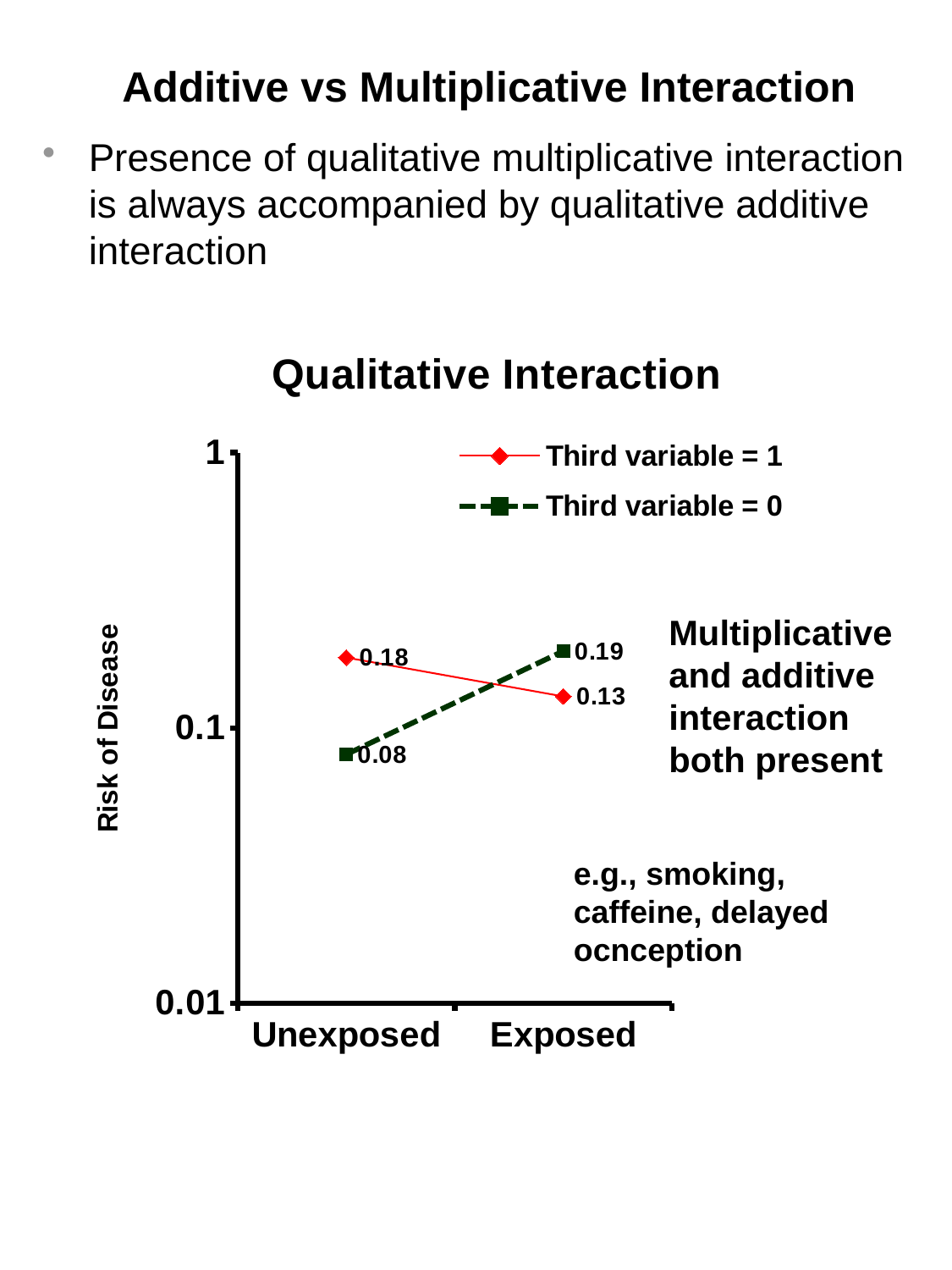
Which category has the lowest risk of disease for the Third variable = 0 series? Unexposed What is the difference in risk of disease between Exposed and Unexposed for the Third variable = 0 series? 0.11 What is the difference in risk of disease between Unexposed and Exposed for the Third variable = 1 series? 0.05 How many series does the legend list? 2 Does the risk of disease for the Third variable = 0 series rise or fall from Unexposed to Exposed? rise For the Unexposed group, which series has the larger risk of disease, Third variable = 1 or Third variable = 0? Third variable = 1 What is the risk of disease for the Unexposed group when Third variable = 0? 0.08 What kind of chart is shown on the slide? line chart What is the risk of disease for the Exposed group when Third variable = 0? 0.19 What is the risk of disease for the Exposed group when Third variable = 1? 0.13 Which category has the highest risk of disease for the Third variable = 1 series? Unexposed What is the risk of disease for the Unexposed group when Third variable = 1? 0.18